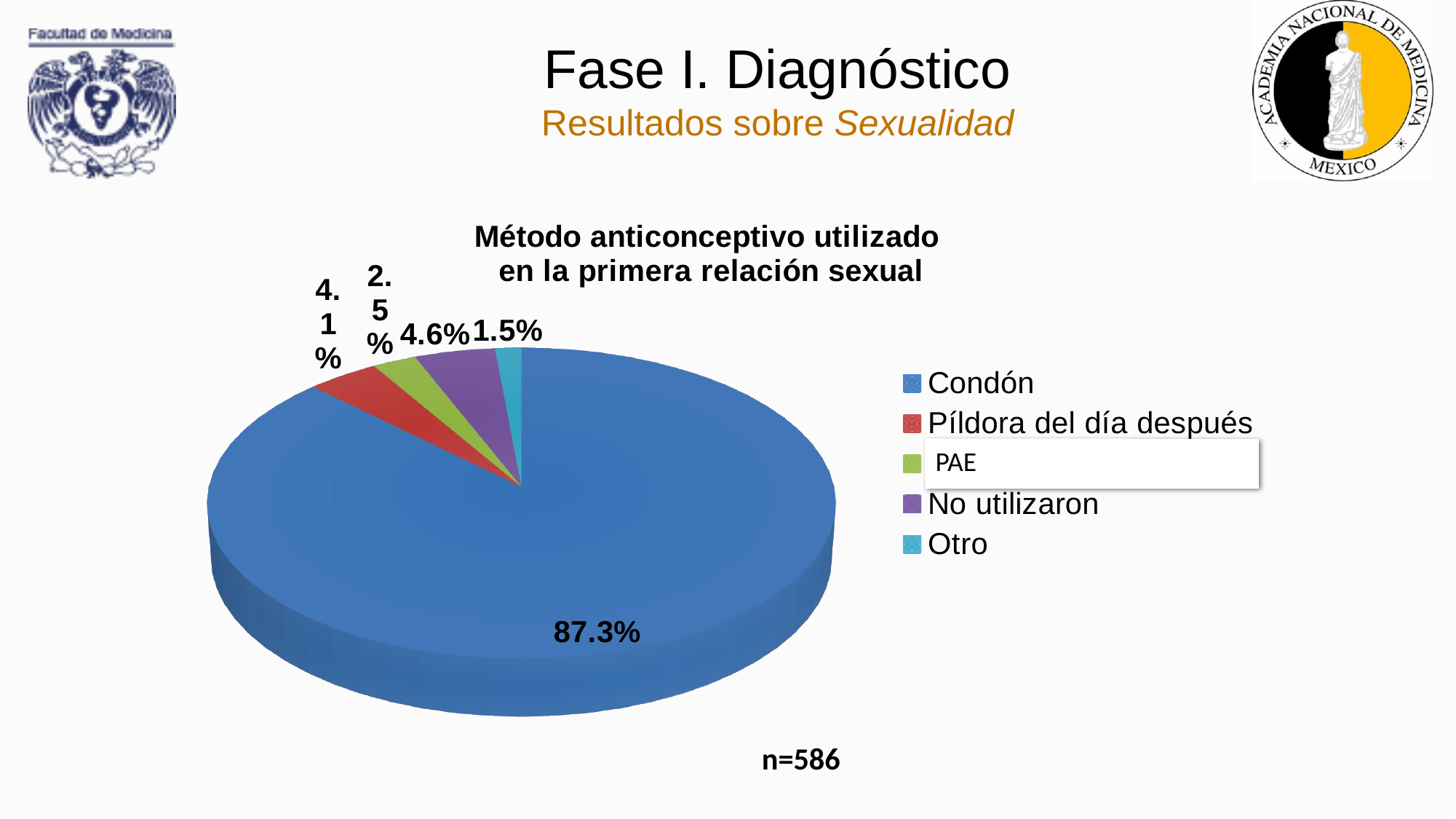
Which category has the largest slice of the pie? Condón What is the difference between the Condón share and the No utilizaron share? 82.7% How many categories does the legend list? 5 What kind of chart is shown on the slide? Pie chart Which category has the smallest slice of the pie? Otro What percentage of the pie corresponds to Píldora del día después? 4.1% What percentage of the pie corresponds to Otro? 1.5% What sample size (n) is stated below the chart? n=586 Which is larger, the share for No utilizaron or the share for Píldora del día después? No utilizaron What is the title of the chart? Método anticonceptivo utilizado en la primera relación sexual What percentage of the pie corresponds to Condón? 87.3% What percentage of the pie corresponds to No utilizaron? 4.6%